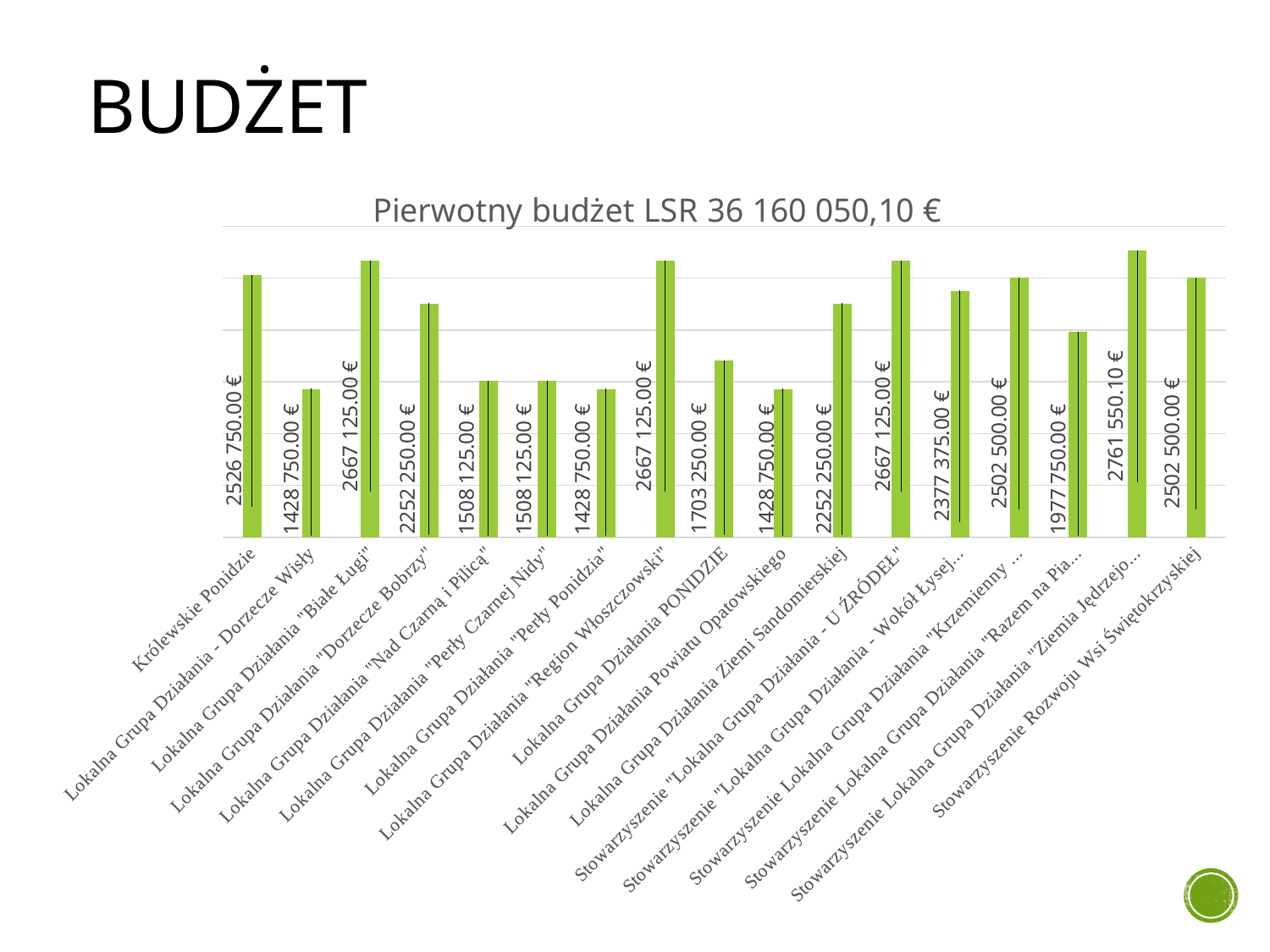
What is the value for Stowarzyszenie Lokalna Grupa Działania "Razem na Pia..."? 1977 750.00 € What is the value for Królewskie Ponidzie? 2526 750.00 € What is the difference between the values for Stowarzyszenie Lokalna Grupa Działania "Ziemia Jędrzejo..." and Stowarzyszenie Lokalna Grupa Działania "Krzemienny ..."? 259 050.10 € What type of chart is shown on the slide? bar chart Which is larger: the value for Lokalna Grupa Działania "Dorzecze Bobrzy" or for Lokalna Grupa Działania "Nad Czarną i Pilicą"? Lokalna Grupa Działania "Dorzecze Bobrzy" What is the difference between the values for Lokalna Grupa Działania "Białe Ługi" and Lokalna Grupa Działania - Dorzecze Wisły? 1238 375.00 € What is the title of the chart? Pierwotny budżet LSR 36 160 050,10 € How many categories (bars) are shown in the chart? 17 What is the value for Stowarzyszenie "Lokalna Grupa Działania - Wokół Łysej..."? 2377 375.00 € What is the lowest value shown in the chart? 1428 750.00 € What is the value for Lokalna Grupa Działania PONIDZIE? 1703 250.00 € Which category has the highest value? Stowarzyszenie Lokalna Grupa Działania "Ziemia Jędrzejo..."